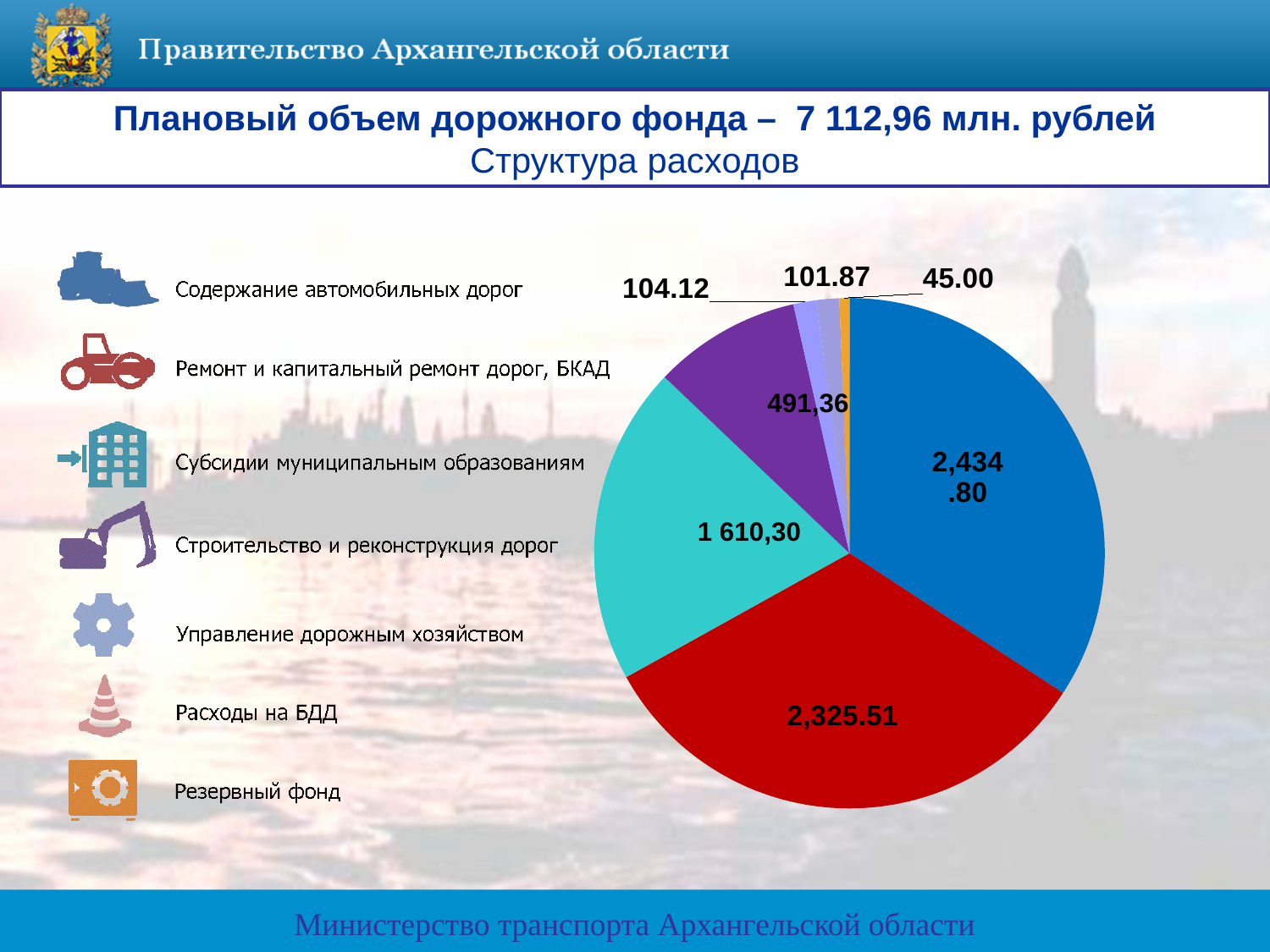
What colour is the slice for Ремонт и капитальный ремонт дорог, БКАД? red What is the value shown for Резервный фонд? 45.00 What is the difference between the values for Содержание автомобильных дорог and Ремонт и капитальный ремонт дорог, БКАД? 109.29 How many slices does the pie chart have? 7 What is the value shown for Ремонт и капитальный ремонт дорог, БКАД? 2,325.51 Which category has the largest slice of the pie? Содержание автомобильных дорог What is the value shown for Субсидии муниципальным образованиям? 1 610,30 What type of chart is shown on the slide? pie chart Which is larger: Субсидии муниципальным образованиям or Строительство и реконструкция дорог? Субсидии муниципальным образованиям What is the value shown for Строительство и реконструкция дорог? 491,36 What is the value shown for Содержание автомобильных дорог? 2,434.80 Which category has the smallest slice of the pie? Резервный фонд